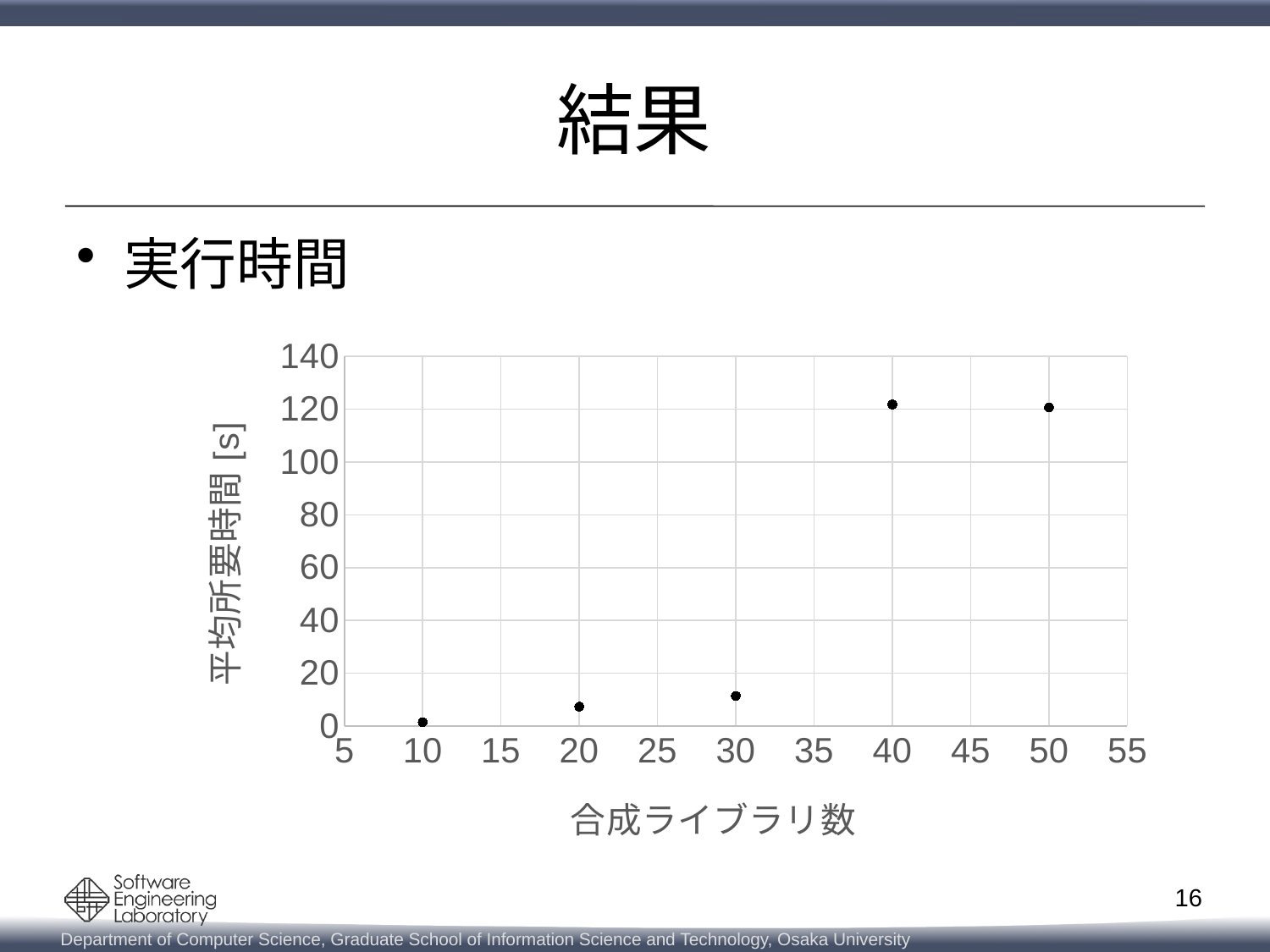
What is the label of the horizontal axis of the chart? 合成ライブラリ数 Is the 平均所要時間 for 合成ライブラリ数 = 20 greater or less than 20? less What kind of chart is shown on the slide? scatter chart Does the 平均所要時間 generally rise or fall as 合成ライブラリ数 increases from 10 to 40? rise Is the 平均所要時間 for 合成ライブラリ数 = 40 greater or less than 100? greater How many data points are plotted in the chart? 5 Is the 平均所要時間 for 合成ライブラリ数 = 30 greater or less than 20? less What is the label of the vertical axis of the chart? 平均所要時間 [s] Which 合成ライブラリ数 value has the lowest 平均所要時間? 10 Which has a larger 平均所要時間: 合成ライブラリ数 = 30 or 合成ライブラリ数 = 40? 40 Which has a larger 平均所要時間: 合成ライブラリ数 = 10 or 合成ライブラリ数 = 30? 30